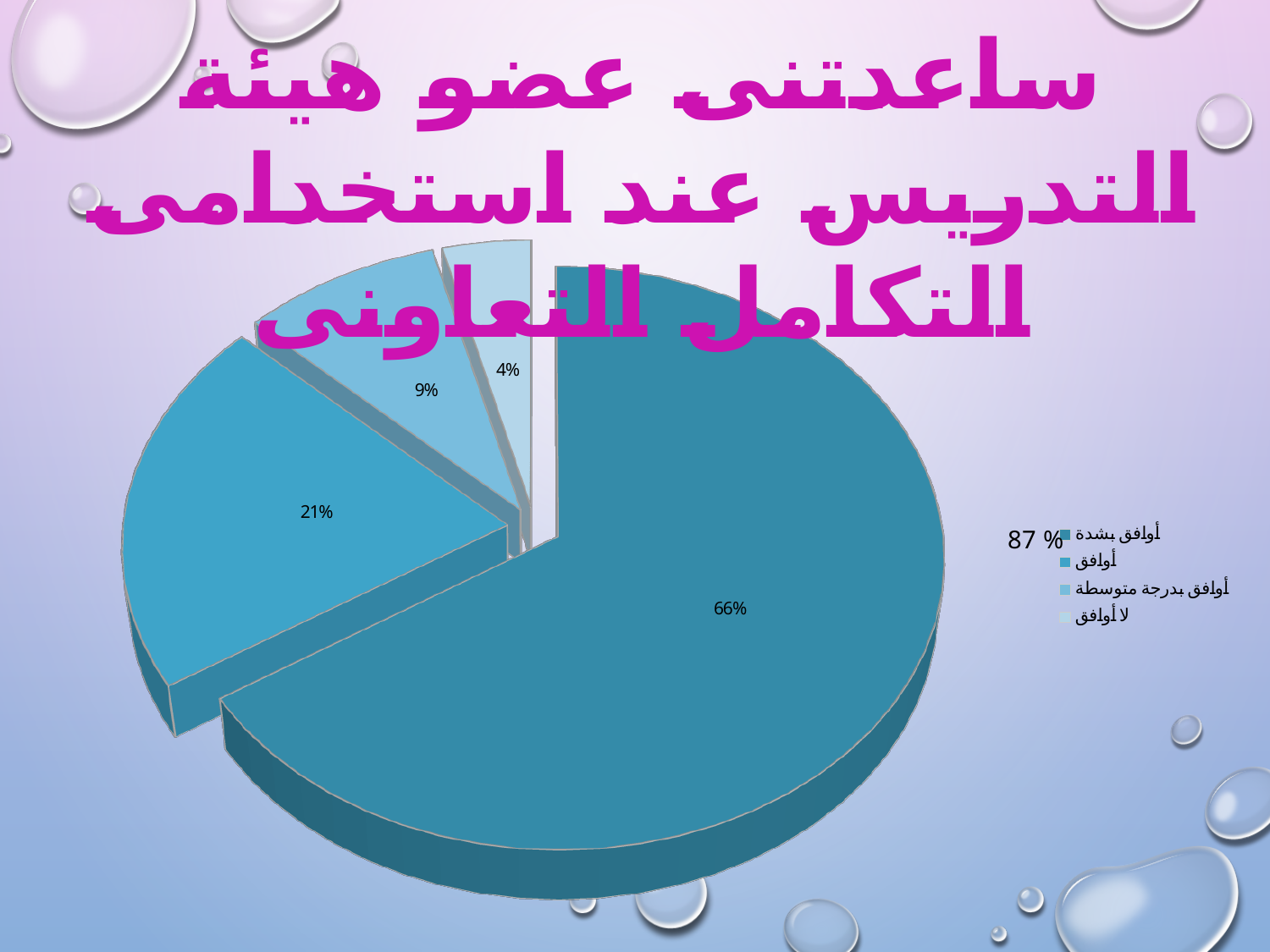
What percentage is shown for the slice labelled أوافق بدرجة متوسطة (moderately agree)? 9% What percentage is shown for the largest slice of the pie chart? 66% How many entries does the legend of the pie chart list? 4 What is the combined share of the two largest slices (66% and 21%)? 87% Which is larger: the slice for أوافق بدرجة متوسطة or the slice for لا أوافق? أوافق بدرجة متوسطة Which legend category has the largest share of the pie chart? أوافق بشدة What percentage is shown for the slice labelled لا أوافق (disagree)? 4% What is the difference between the largest slice (66%) and the second largest slice (21%)? 45 percentage points How many slices does the pie chart have? 4 Which legend category has the smallest share of the pie chart? لا أوافق What percentage is shown for the slice labelled أوافق (agree)? 21% What kind of chart is shown on the slide? pie chart